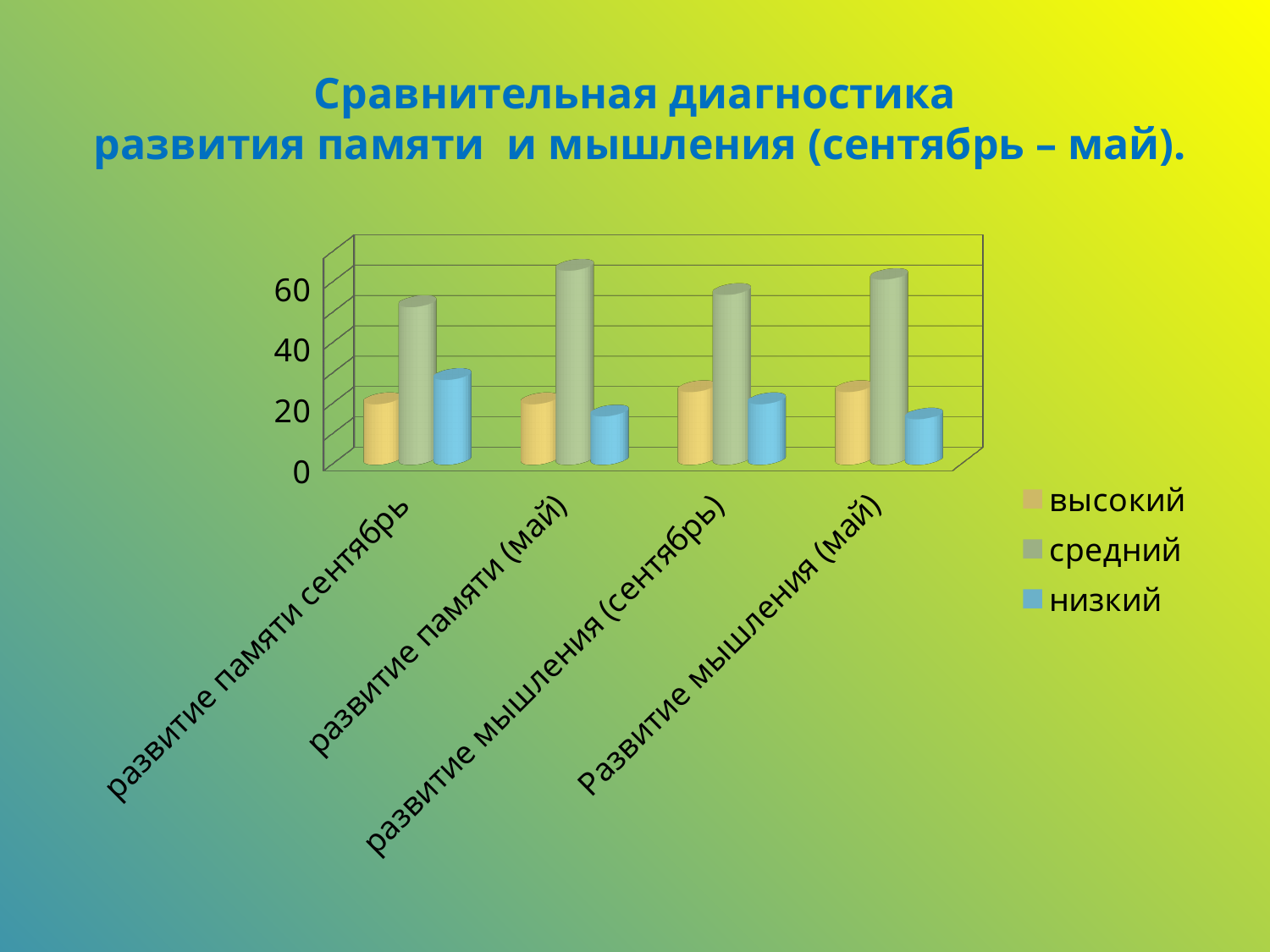
What kind of chart is shown on the slide? bar chart Which series is lowest in the category 'развитие памяти сентябрь'? высокий Is the value for 'высокий' in 'развитие памяти (май)' greater or less than 40? less Is the value for 'средний' in 'развитие памяти сентябрь' greater or less than 40? greater How many series does the chart's legend list? 3 Which is larger in the category 'развитие памяти (май)': 'средний' or 'высокий'? средний Which series is highest in the category 'Развитие мышления (май)'? средний Which is larger for the 'низкий' series: 'развитие памяти сентябрь' or 'развитие памяти (май)'? развитие памяти сентябрь Which series is highest in the category 'развитие памяти сентябрь'? средний How many categories are shown on the x axis of the chart? 4 What colour are the bars for the 'низкий' series? blue What are the three entries in the chart's legend? высокий, средний, низкий